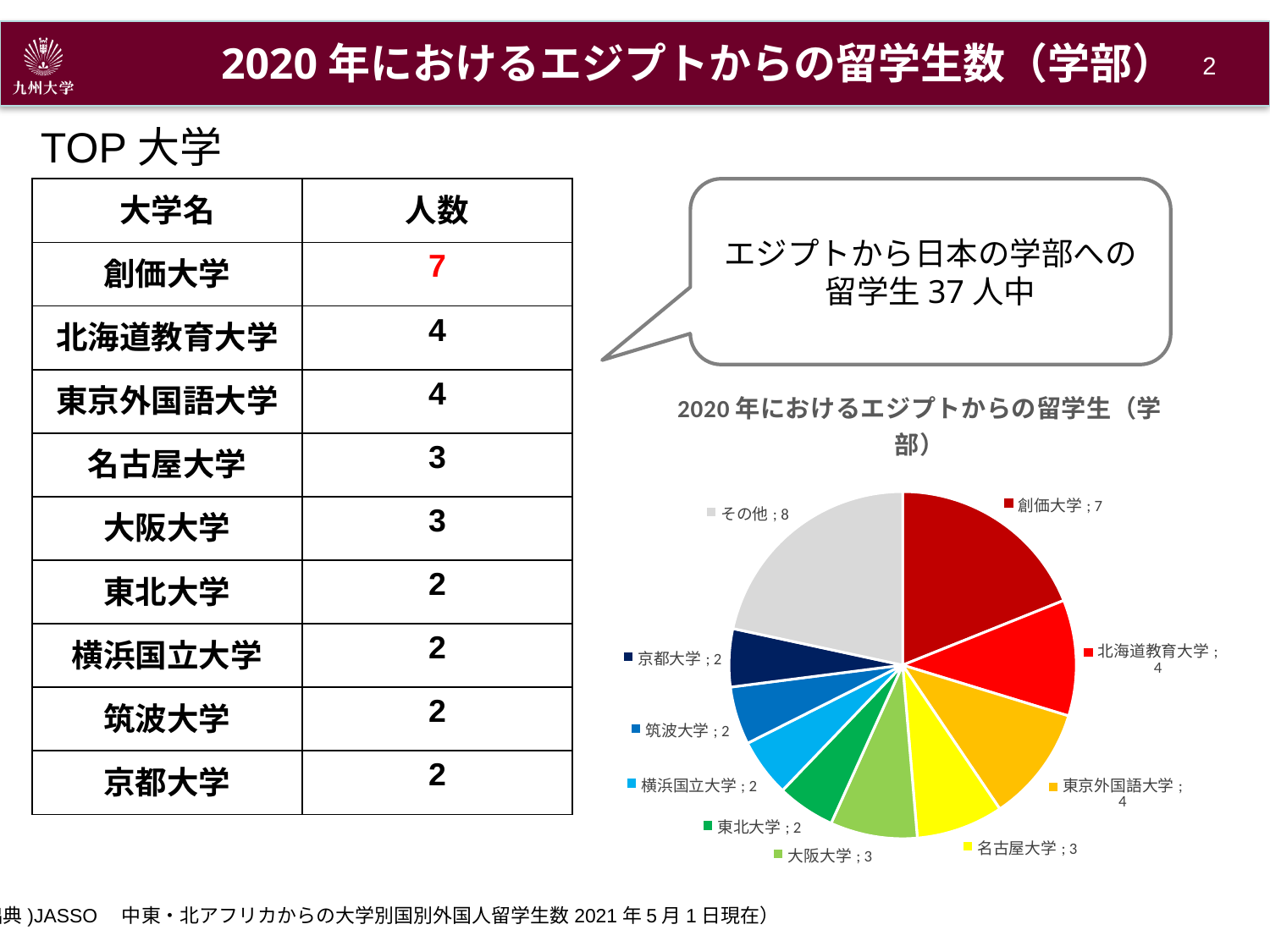
What colour is the 創価大学 slice in the pie chart? dark red In the pie chart, how many students are shown for 名古屋大学? 3 In the pie chart, what is the value for その他? 8 What is the difference between the values for 創価大学 and 北海道教育大学 in the pie chart? 3 What is the title of the pie chart? 2020年におけるエジプトからの留学生（学部） Among the named universities in the pie chart, which has the highest number of students? 創価大学 What is the difference between the values for その他 and 東北大学 in the pie chart? 6 Which slice of the pie chart is the largest? その他 In the pie chart, how many students are shown for 創価大学? 7 In the pie chart, which is larger: the value for 大阪大学 or the value for 京都大学? 大阪大学 How many slices does the pie chart have? 10 What kind of chart is shown on the slide? pie chart